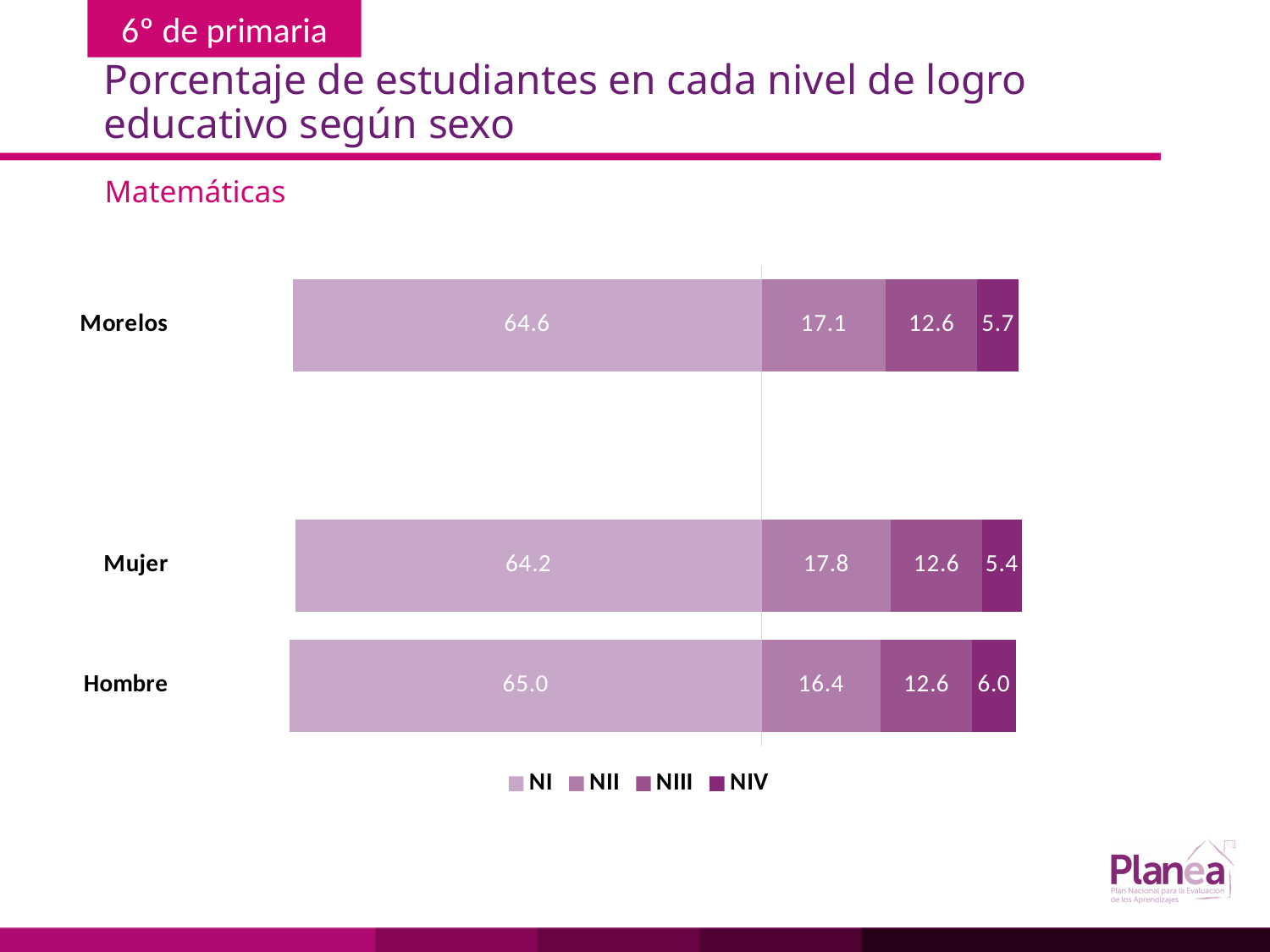
What is the total of the stacked bar for Morelos? 100.0 What is the NII value for Mujer? 17.8 What is the NI value for Morelos? 64.6 What kind of chart is shown on the slide? Stacked bar chart Which category has the highest NI value? Hombre What is the NIII value for Hombre? 12.6 Which is larger, the NI value for Hombre or the NI value for Mujer? Hombre What is the difference between the NII values for Mujer and Hombre? 1.4 How many series does the legend list? 4 How many categories are shown on the chart? 3 What is the NIV value for Hombre? 6.0 Which category has the lowest NIV value? Mujer